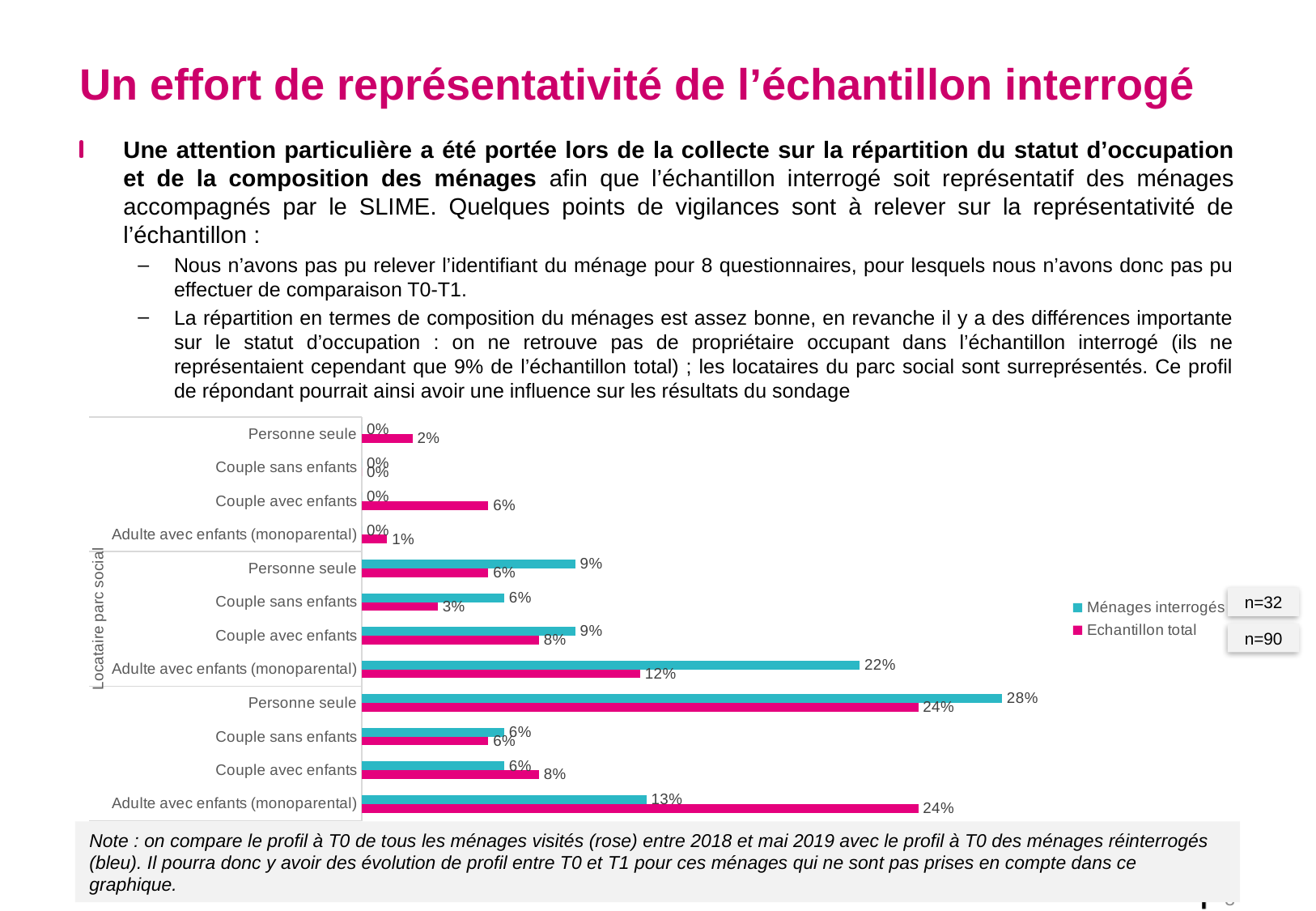
In the Locataire parc social group, for Personne seule, which series has the larger value: Ménages interrogés or Echantillon total? Ménages interrogés What are the two series names listed in the chart's legend? Ménages interrogés and Echantillon total How many category rows are plotted on the chart? 12 What is the highest value shown for the Ménages interrogés series on the chart? 28% In the Locataire parc social group, what is the value for Echantillon total for Couple avec enfants? 8% How many series does the chart's legend list? 2 What kind of chart is shown on the slide? Bar chart In the Locataire parc social group, what is the value for Echantillon total for Couple sans enfants? 3% In the Locataire parc social group, what is the difference between Ménages interrogés and Echantillon total for Couple sans enfants? 3 percentage points In the Locataire parc social group, what is the difference between Ménages interrogés and Echantillon total for Adulte avec enfants (monoparental)? 10 percentage points In the Locataire parc social group, which category has the highest Echantillon total value? Adulte avec enfants (monoparental) In the Locataire parc social group, what is the value for Ménages interrogés for Adulte avec enfants (monoparental)? 22%